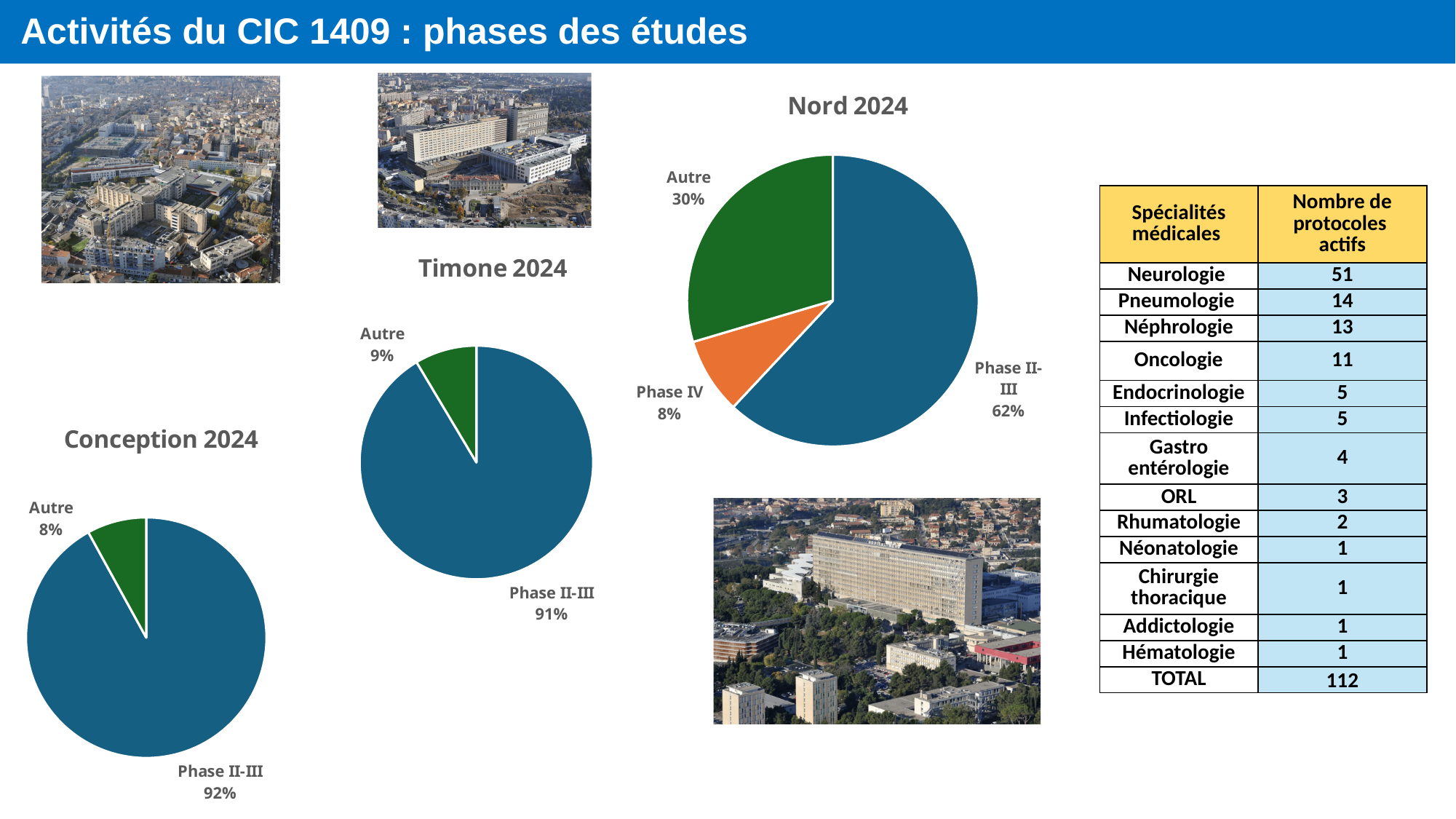
In the "Timone 2024" chart, what share does Phase II-III have? 91% How many slices does the "Nord 2024" chart have? 3 What kind of chart is the "Nord 2024" chart? pie chart In the "Conception 2024" chart, what share does Phase II-III have? 92% In the "Nord 2024" chart, what share does Phase IV have? 8% In the "Nord 2024" chart, which slice is the smallest? Phase IV In the "Conception 2024" chart, what is the difference between the Phase II-III share and the Autre share? 84% Which is larger: the Autre share in the "Nord 2024" chart or the Autre share in the "Timone 2024" chart? Nord 2024 In the "Conception 2024" chart, which slice is the largest? Phase II-III